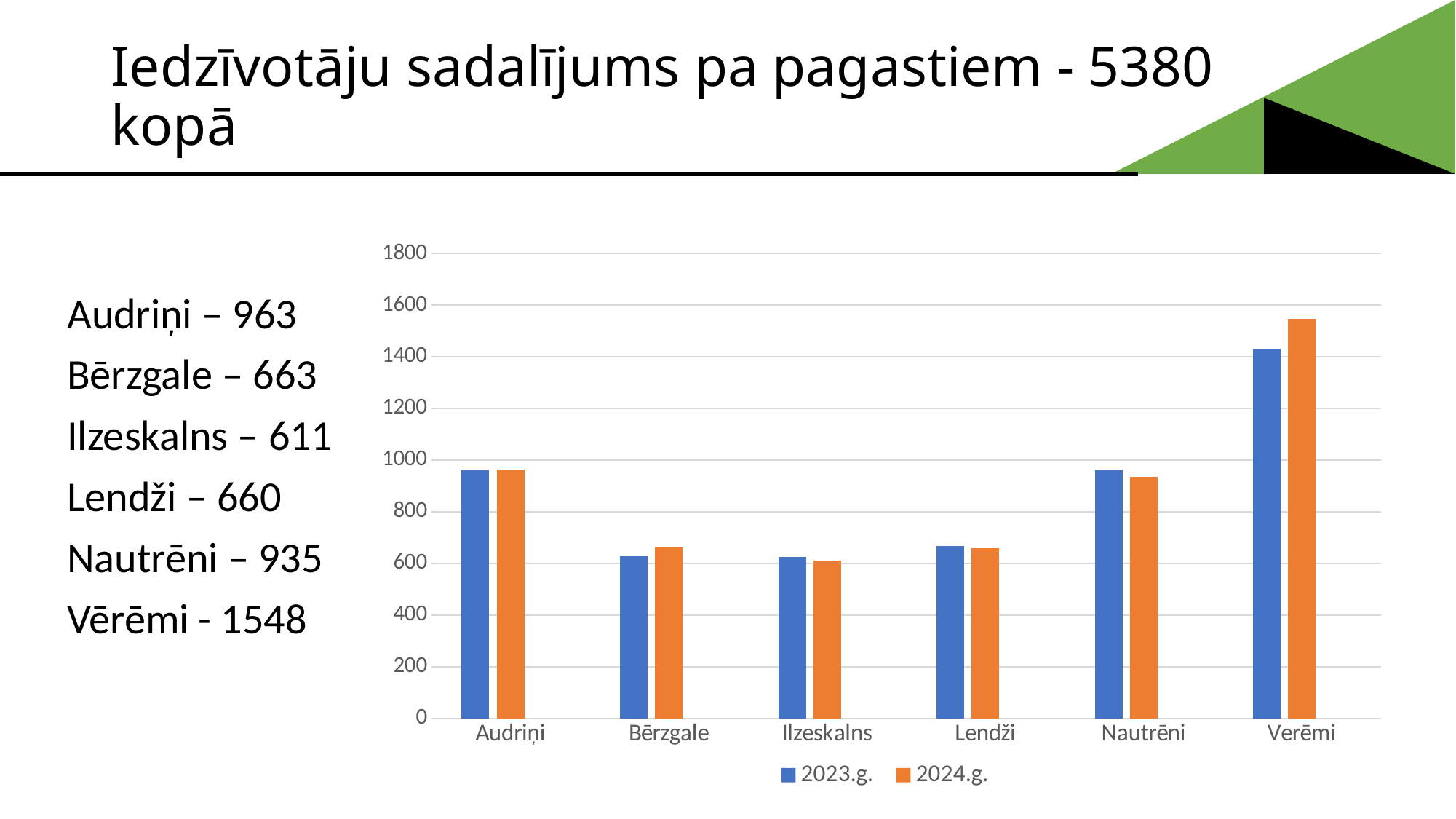
For Nautrēni, which series has the larger value, 2023.g. or 2024.g.? 2023.g. Which parish has the lowest value in the 2024.g. series? Ilzeskalns Which parish has the highest value in the 2024.g. series? Verēmi What are the two series named in the chart legend? 2023.g. and 2024.g. Is the 2023.g. value for Lendži greater or less than 600? greater What kind of chart is shown on the slide? bar chart Is the 2023.g. value for Audriņi greater or less than 1000? less For Verēmi, which series has the larger value, 2023.g. or 2024.g.? 2024.g. Is the 2024.g. value for Verēmi greater or less than 1400? greater How many series does the chart legend list? 2 Which parish has the highest value in the 2023.g. series? Verēmi How many parishes (categories) are shown on the x axis of the chart? 6